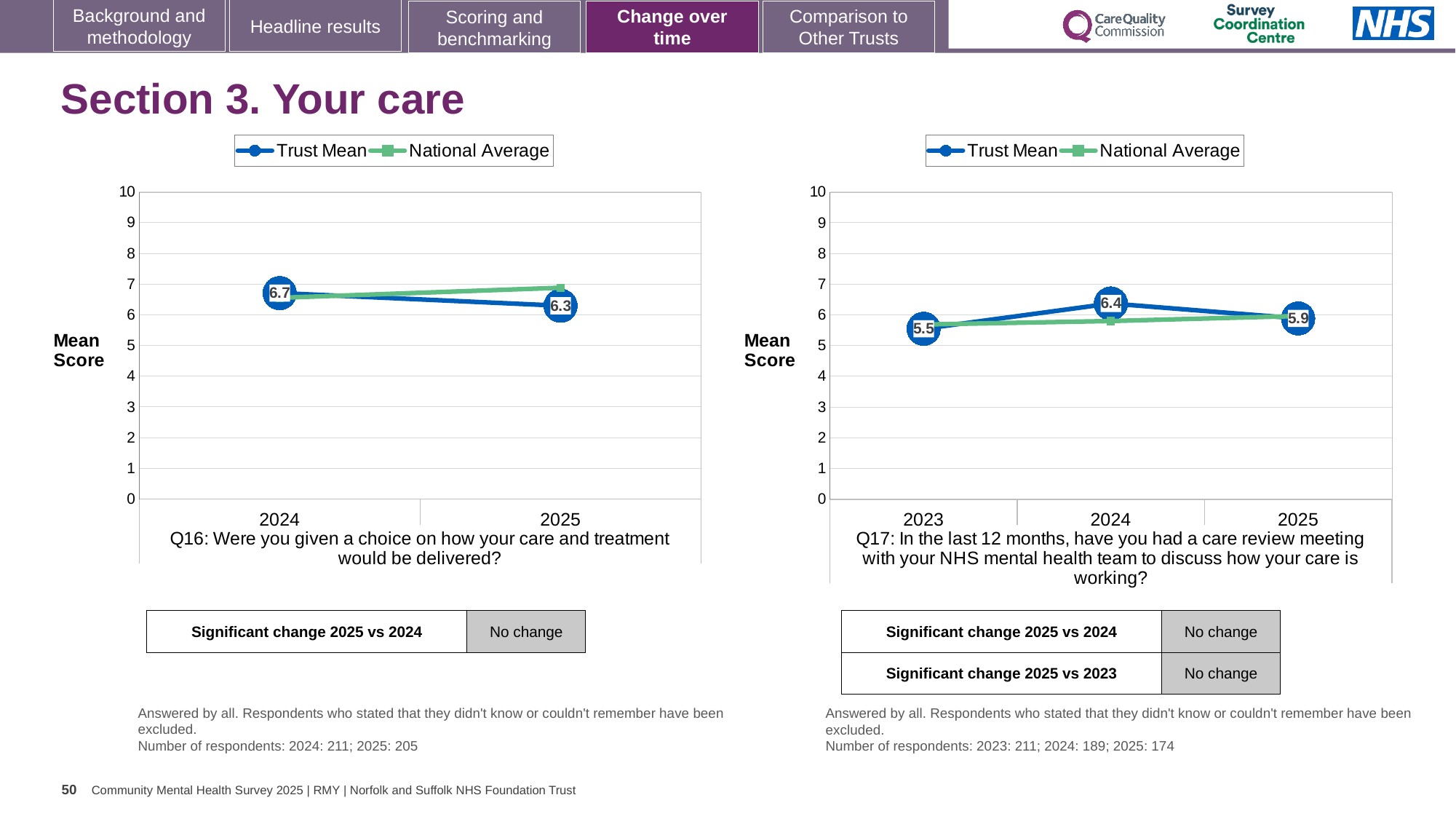
In the Q17 chart (right), which year has the highest Trust Mean? 2024 In the Q17 chart (right), what is the Trust Mean for 2024? 6.4 In the Q17 chart (right), how many years are plotted on the x axis? 3 In the Q16 chart (left), what is the Trust Mean for 2024? 6.7 In the Q16 chart (left), what is the Trust Mean for 2025? 6.3 In the Q17 chart (right), which year has the lowest Trust Mean? 2023 In the Q16 chart (left), does the Trust Mean rise or fall from 2024 to 2025? fall In the Q17 chart (right), what is the Trust Mean for 2023? 5.5 In the Q16 chart (left), how many series does the legend list? 2 In the Q17 chart (right), what is the difference between the Trust Mean in 2024 and 2025? 0.5 What kind of chart is the Q17 chart (right)? line chart In the Q16 chart (left), by how much did the Trust Mean fall from 2024 to 2025? 0.4